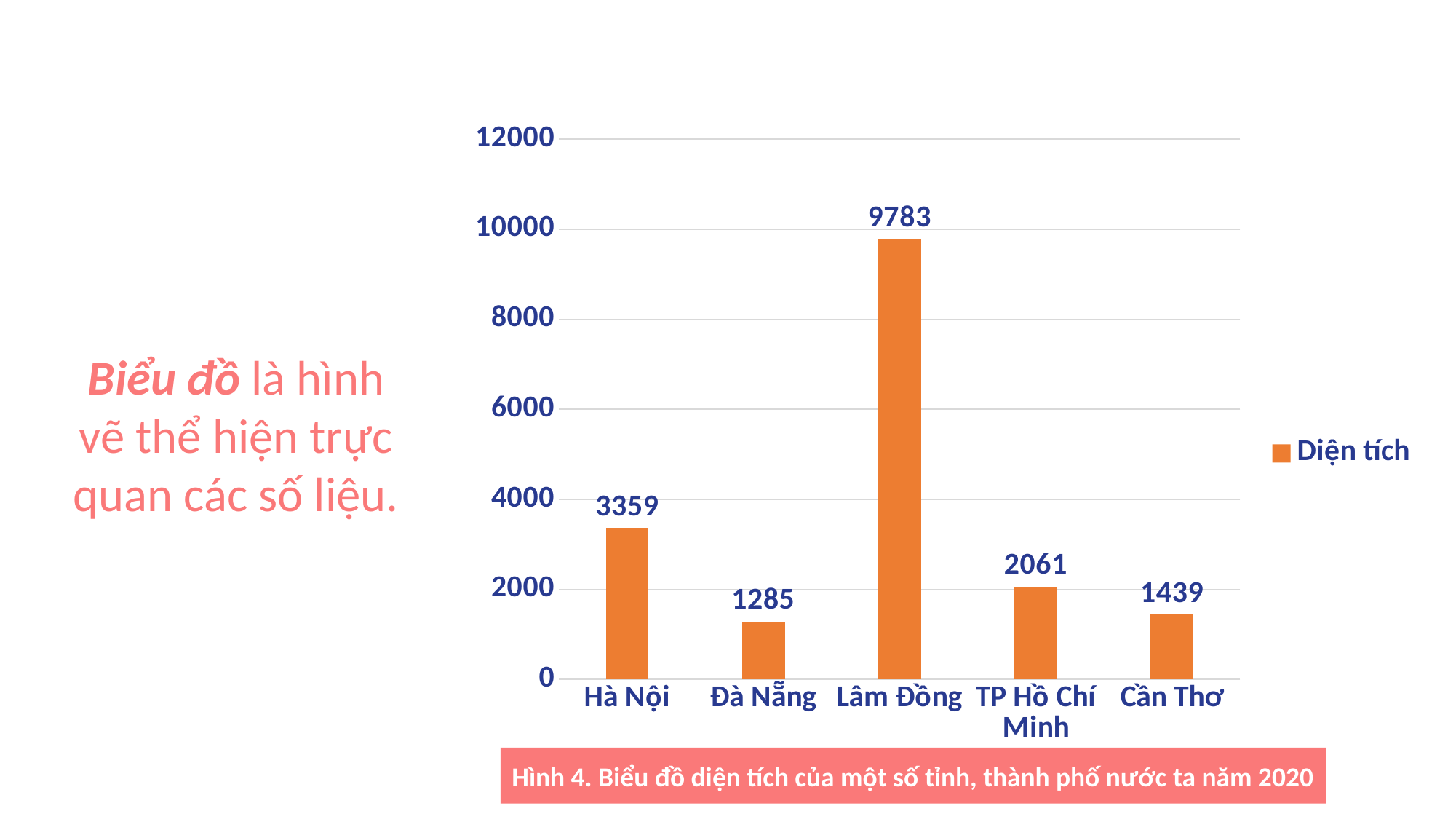
What is the value for Lâm Đồng? 9783 What series name does the legend show? Diện tích Which category has the lowest value? Đà Nẵng How many categories are shown on the x axis? 5 What is the difference between the values for Lâm Đồng and Hà Nội? 6424 What is the value for Hà Nội? 3359 Is the value for Lâm Đồng greater or less than 8000? greater Which category has the highest value? Lâm Đồng What is the value for Cần Thơ? 1439 What kind of chart is shown on the slide? bar chart Which is larger, the value for Hà Nội or the value for TP Hồ Chí Minh? Hà Nội What is the difference between the values for TP Hồ Chí Minh and Đà Nẵng? 776